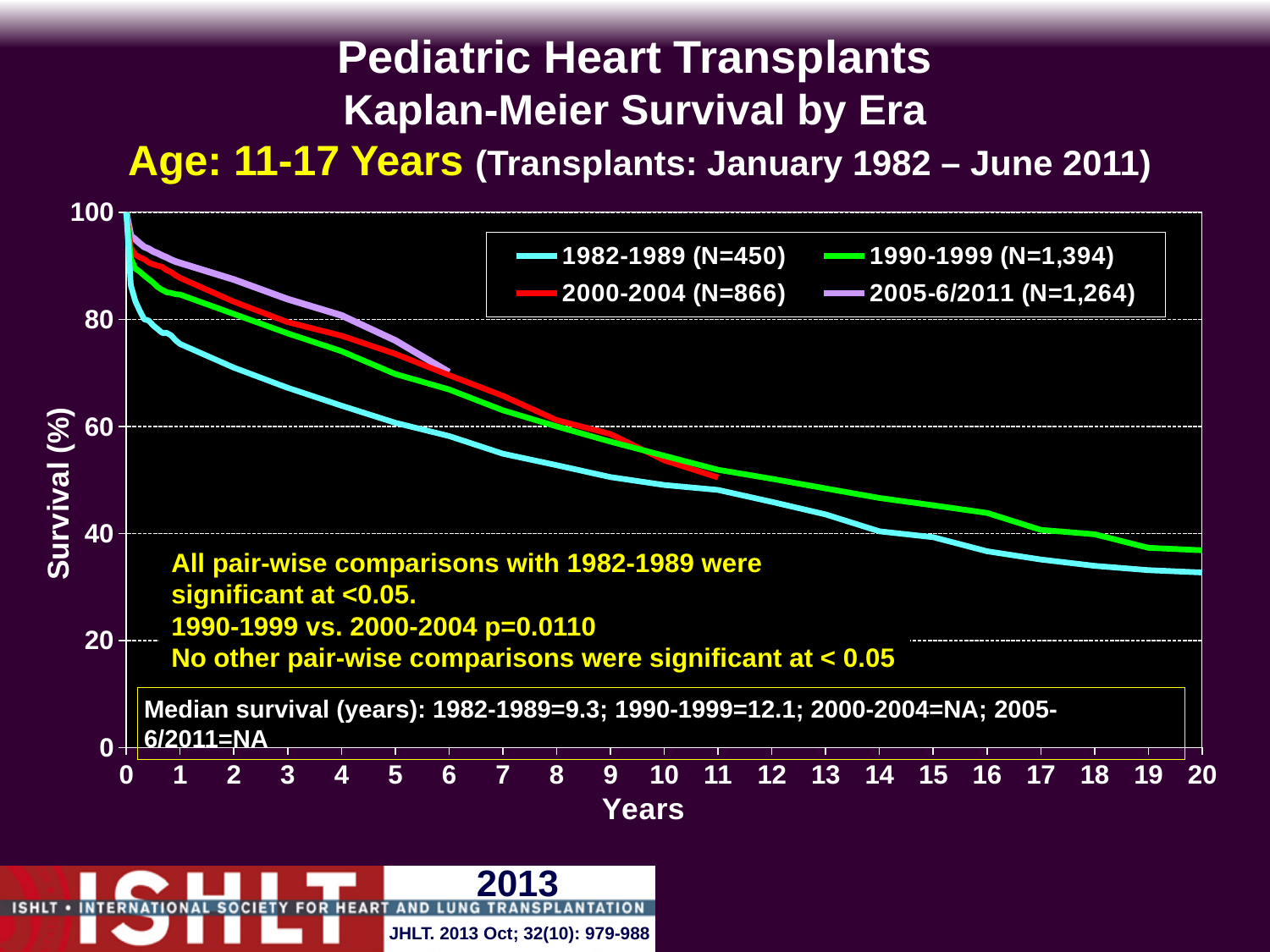
Which era has the lowest survival curve across the chart? 1982-1989 What kind of chart is shown on the slide? line chart What is the N for the 2005-6/2011 era shown in the legend? 1,264 What is the median survival for the 2000-2004 era? NA Do the survival curves rise or fall as years increase? fall What is the N for the 1990-1999 era shown in the legend? 1,394 How many series does the legend list? 4 What is the median survival in years for the 1990-1999 era? 12.1 At 1 year, which era has higher survival: 2005-6/2011 or 1982-1989? 2005-6/2011 What is the median survival in years for the 1982-1989 era? 9.3 Is the survival value for the 1982-1989 era at 20 years greater or less than 40? less Is the survival value for the 2005-6/2011 era at 6 years greater or less than 60? greater